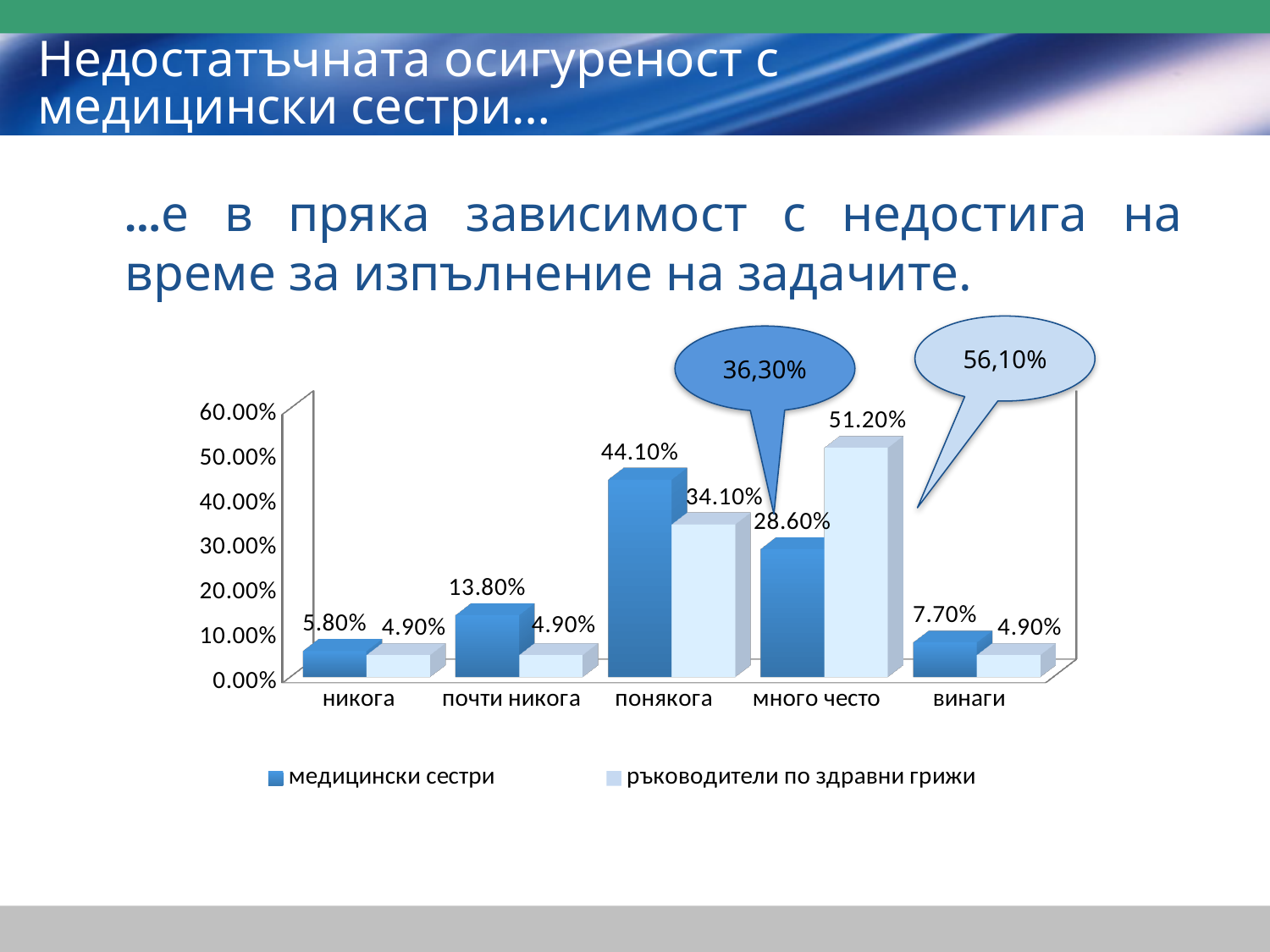
What is the difference between the two series in the category много често? 22.60% What is the value for медицински сестри in the category почти никога? 13.80% In the category понякога, which series has the larger value? медицински сестри What is the value for медицински сестри in the category понякога? 44.10% Is the value for медицински сестри in the category много често greater or less than 20.00%? greater What value is shown in the light blue callout above the chart? 56,10% What is the value for ръководители по здравни грижи in the category много често? 51.20% How many categories are shown on the x axis? 5 How many series does the legend list? 2 Which category has the highest value for медицински сестри? понякога Which category has the highest value for ръководители по здравни грижи? много често What type of chart is shown on the slide? bar chart